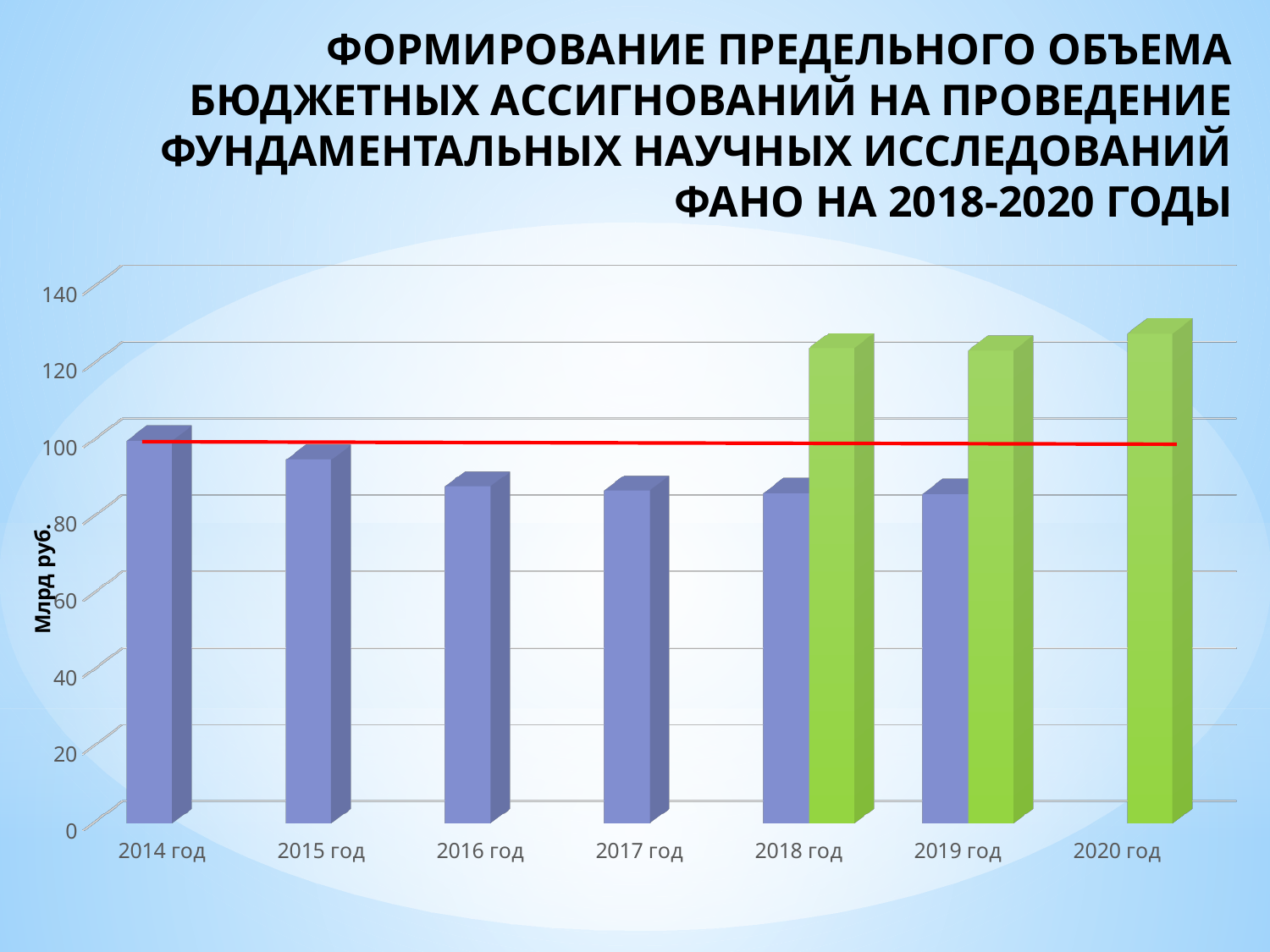
What kind of chart is shown on the slide? bar chart Is the value of the green bar for 2018 год greater or less than 120? greater Which year has the tallest bar in the chart? 2020 год What is the label on the vertical axis of the chart? Млрд руб. Among the blue bars, which year has the highest value? 2014 год Do the blue bars rise or fall from 2014 год to 2017 год? fall How many years are shown on the x axis of the chart? 7 Is the value of the green bar for 2020 год greater or less than 120? greater Is the value of the blue bar for 2017 год greater or less than 80? greater Which is larger: the blue bar for 2014 год or the blue bar for 2015 год? 2014 год For 2019 год, which bar is larger: the blue bar or the green bar? the green bar